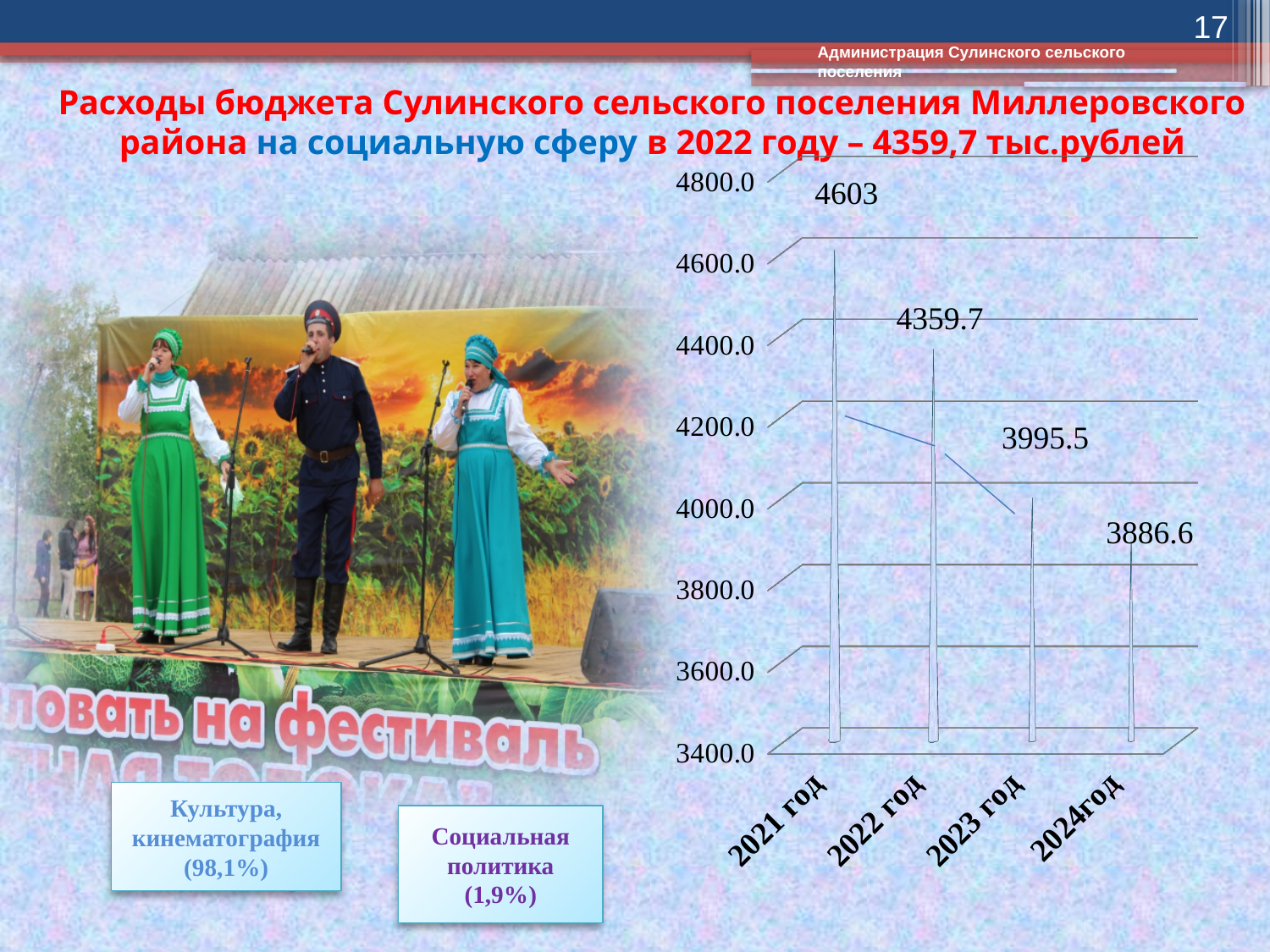
What kind of chart is shown on the slide? bar chart Which year has the lowest value? 2024год What is the value for 2022 год? 4359.7 What is the difference between the values for 2023 год and 2024год? 108.9 Which is larger, the value for 2022 год or the value for 2023 год? 2022 год How many years are shown on the x axis of the chart? 4 What is the value for 2023 год? 3995.5 What is the value for 2021 год? 4603 What is the difference between the values for 2021 год and 2022 год? 243.3 What is the value for 2024год? 3886.6 Which year has the highest value? 2021 год Do the values rise or fall from 2021 год to 2024год? fall